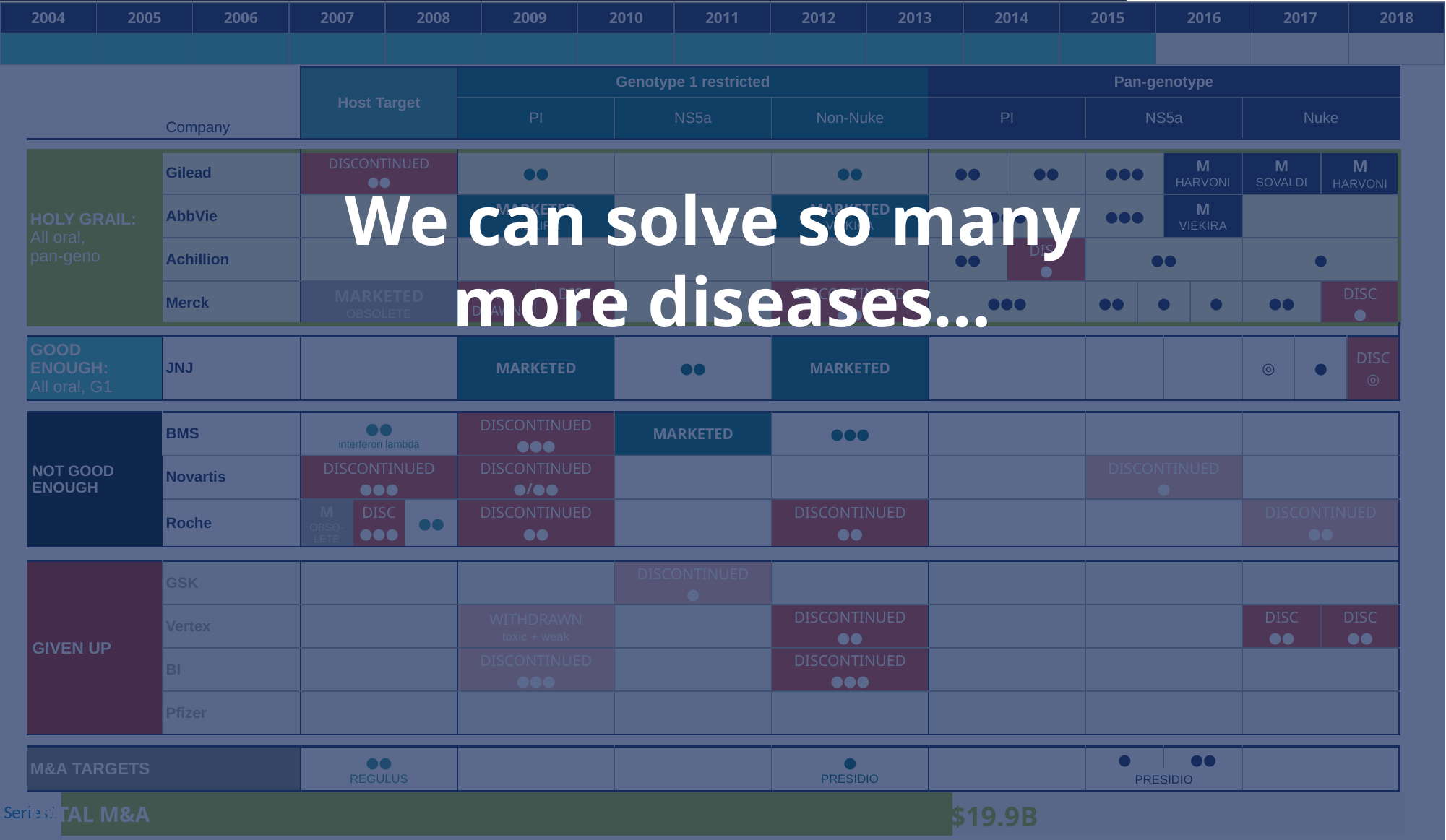
What value is printed on the horizontal bar at the bottom of the slide labelled TOTAL M&A? $19.9B What is the first year shown on the timeline across the top of the slide? 2004 What kind of chart is the TOTAL M&A element at the bottom of the slide? bar chart How many bars does the TOTAL M&A chart at the bottom of the slide show? 1 Through which year does the teal shaded portion of the timeline at the top of the slide extend? 2015 What is the last year shown on the timeline across the top of the slide? 2018 How many year columns are shown on the timeline across the top of the slide? 15 Is the TOTAL M&A bar at the bottom of the slide oriented horizontally or vertically? horizontally